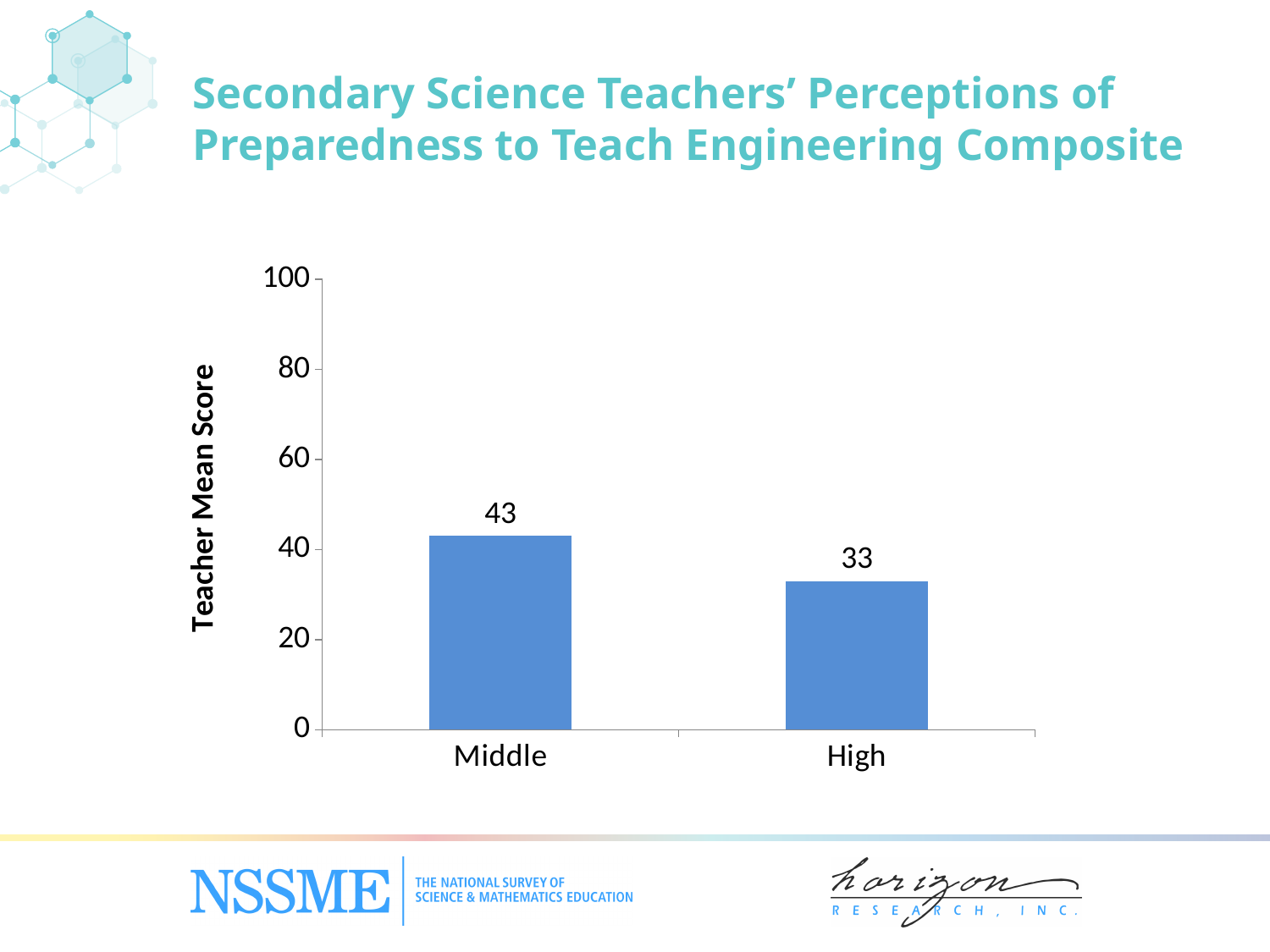
What is the teacher mean score for Middle? 43 What is the difference between the teacher mean scores for Middle and High? 10 Which has a larger teacher mean score, Middle or High? Middle What is the teacher mean score for High? 33 Is the value for Middle greater or less than 40? greater Is the value for High greater or less than 40? less Do the values rise or fall from Middle to High? Fall What kind of chart is shown on the slide? Bar chart What is the label of the vertical axis? Teacher Mean Score Which category has the highest teacher mean score? Middle How many categories are shown on the x axis? 2 Which category has the lowest teacher mean score? High